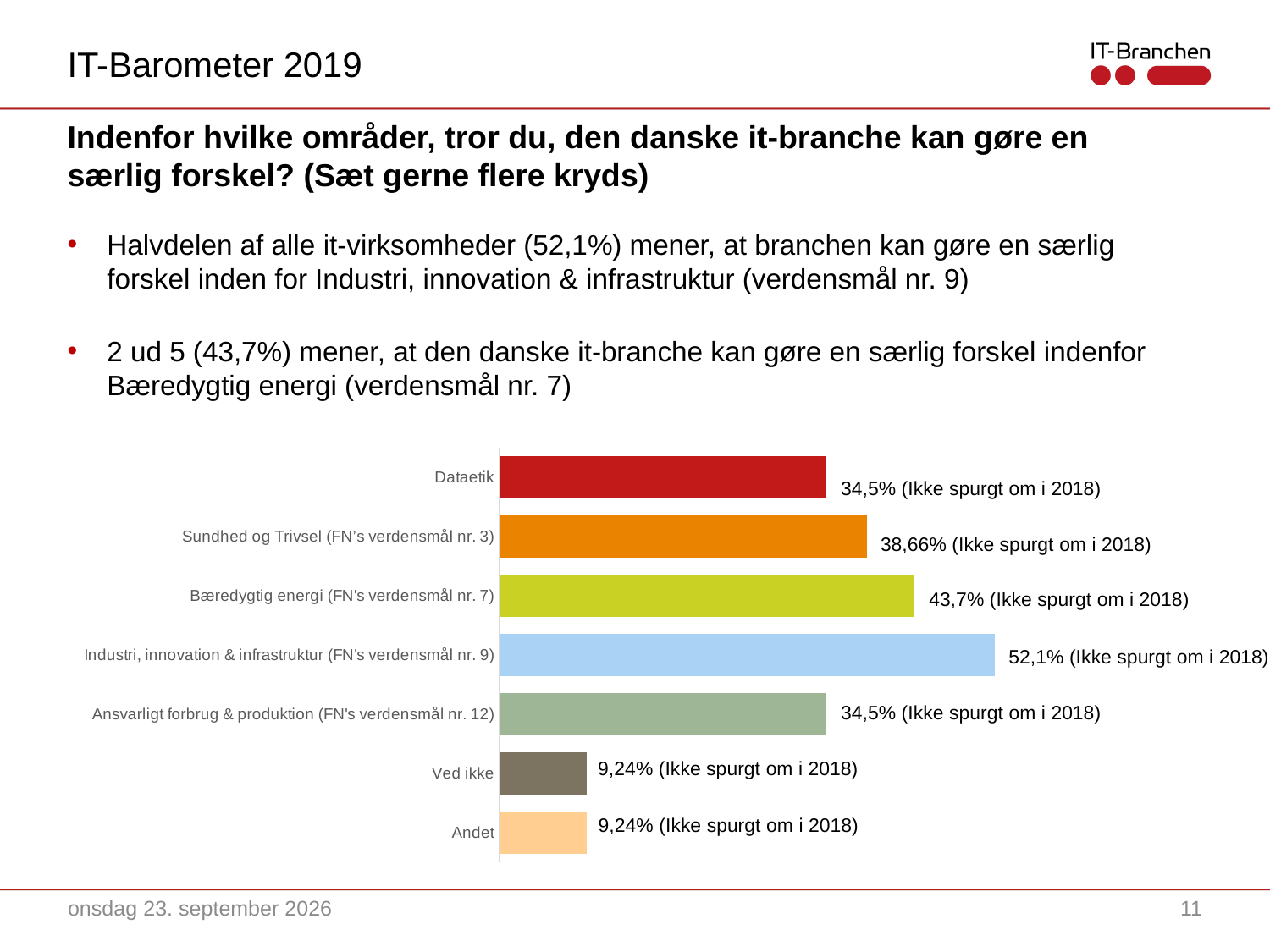
Which category has the highest value? Industri, innovation & infrastruktur (FN's verdensmål nr. 9) What kind of chart is shown on the slide? Bar chart What is the difference between the values for Bæredygtig energi and Sundhed og Trivsel? 5,04 percentage points What is the value for Ved ikke? 9,24% What note is printed after each data label in the chart? (Ikke spurgt om i 2018) What is the value for Bæredygtig energi (FN's verdensmål nr. 7)? 43,7% Which is larger, the value for Sundhed og Trivsel or the value for Ansvarligt forbrug & produktion? Sundhed og Trivsel What is the value for Industri, innovation & infrastruktur (FN's verdensmål nr. 9)? 52,1% How many categories does the bar chart show? 7 What is the value for Dataetik? 34,5% What is the difference between the values for Industri, innovation & infrastruktur and Bæredygtig energi? 8,4 percentage points What is the value for Sundhed og Trivsel (FN's verdensmål nr. 3)? 38,66%